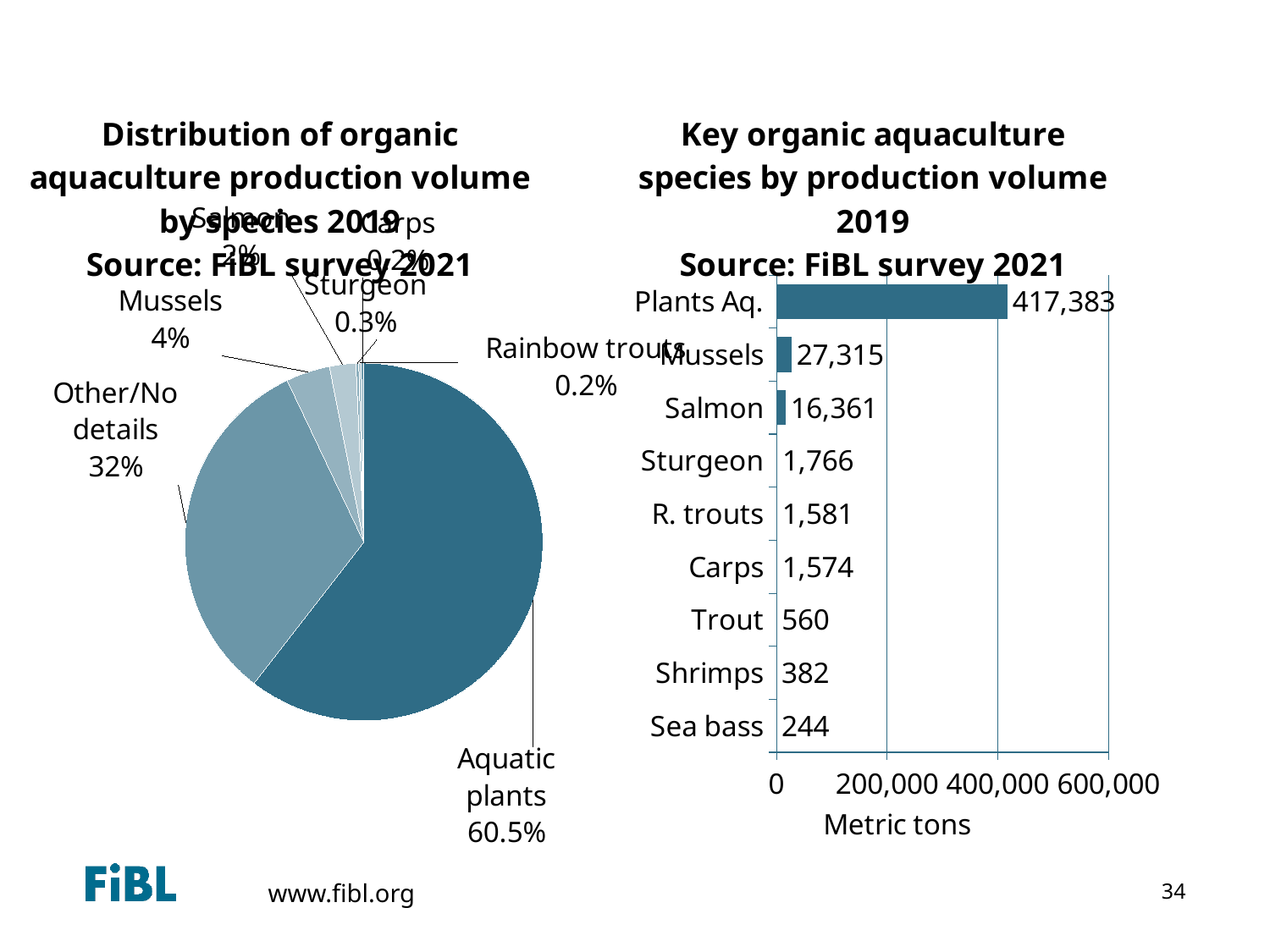
In the bar chart on the right, which has a larger production volume, Sturgeon or Trout? Sturgeon In the bar chart on the right, what is the production volume for Sea bass? 244 How many species are shown in the bar chart on the right? 9 In the bar chart on the right, what is the difference between the production volumes of Mussels and Salmon? 10,954 In the pie chart on the left, what share of production volume do Aquatic plants account for? 60.5% In the bar chart on the right, what is the production volume for Plants Aq.? 417,383 In the bar chart on the right, what is the production volume for Mussels? 27,315 In the bar chart on the right, which species has the lowest production volume? Sea bass What type of chart is the chart on the left of the slide? Pie chart What is the x-axis label of the bar chart on the right? Metric tons In the bar chart on the right, which species has the highest production volume? Plants Aq. In the pie chart on the left, what share of production volume is labelled Other/No details? 32%